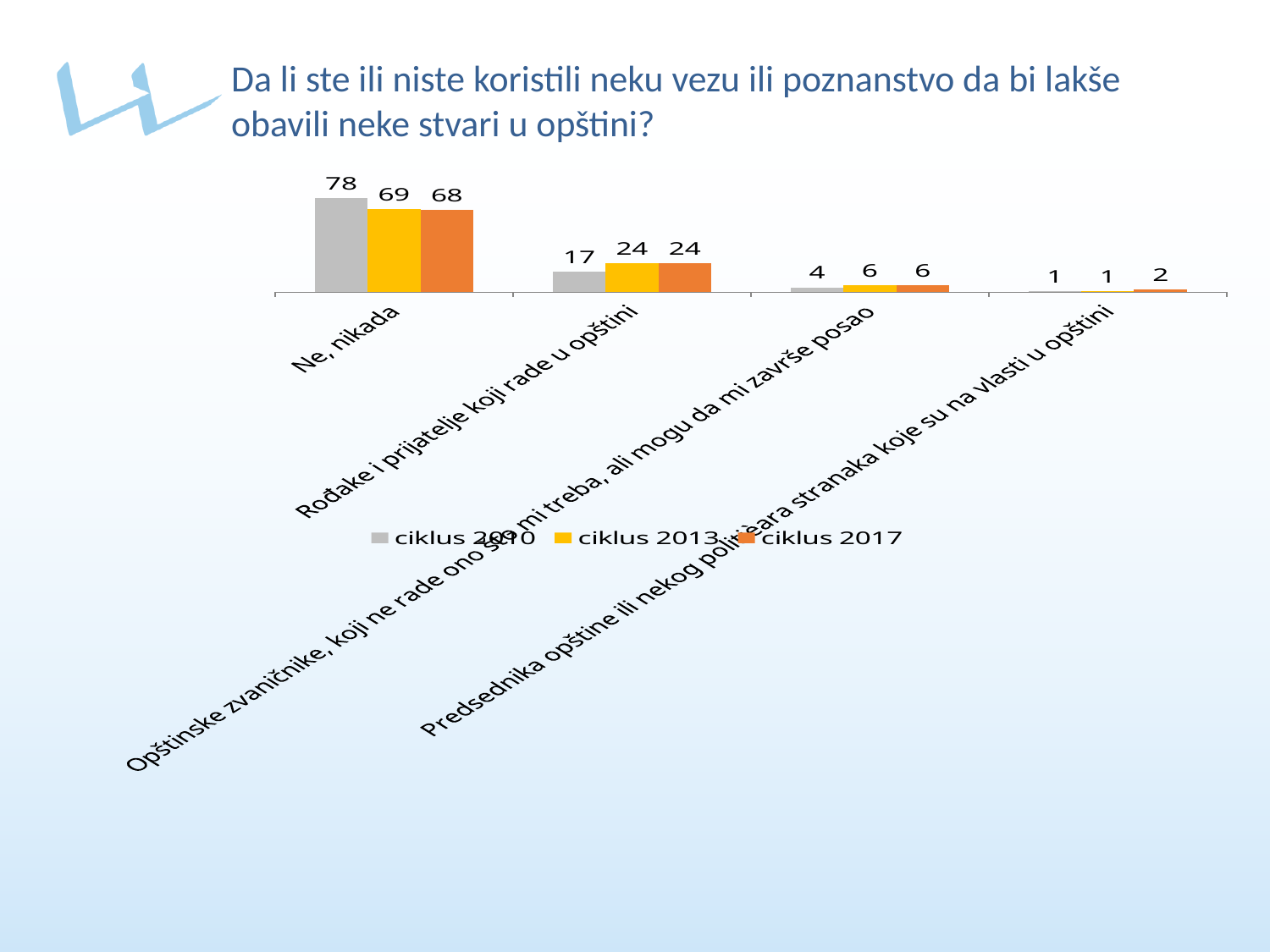
What is the value for "Ne, nikada" in the ciklus 2017 series? 68 What is the difference between the ciklus 2010 and ciklus 2013 values for "Ne, nikada"? 9 What is the value for "Rođake i prijatelje koji rade u opštini" in the ciklus 2013 series? 24 How many series does the legend list? 3 What colour are the bars for the ciklus 2013 series? yellow What is the value for "Ne, nikada" in the ciklus 2010 series? 78 For "Rođake i prijatelje koji rade u opštini", which is larger: the ciklus 2010 value or the ciklus 2017 value? ciklus 2017 Which category has the highest value in the ciklus 2013 series? Ne, nikada What is the value for "Opštinske zvaničnike, koji ne rade ono što mi treba, ali mogu da mi završe posao" in the ciklus 2010 series? 4 How many categories are shown on the x axis? 4 Which category has the lowest value in the ciklus 2017 series? Predsednika opštine ili nekog političara stranaka koje su na vlasti u opštini What kind of chart is shown on the slide? bar chart